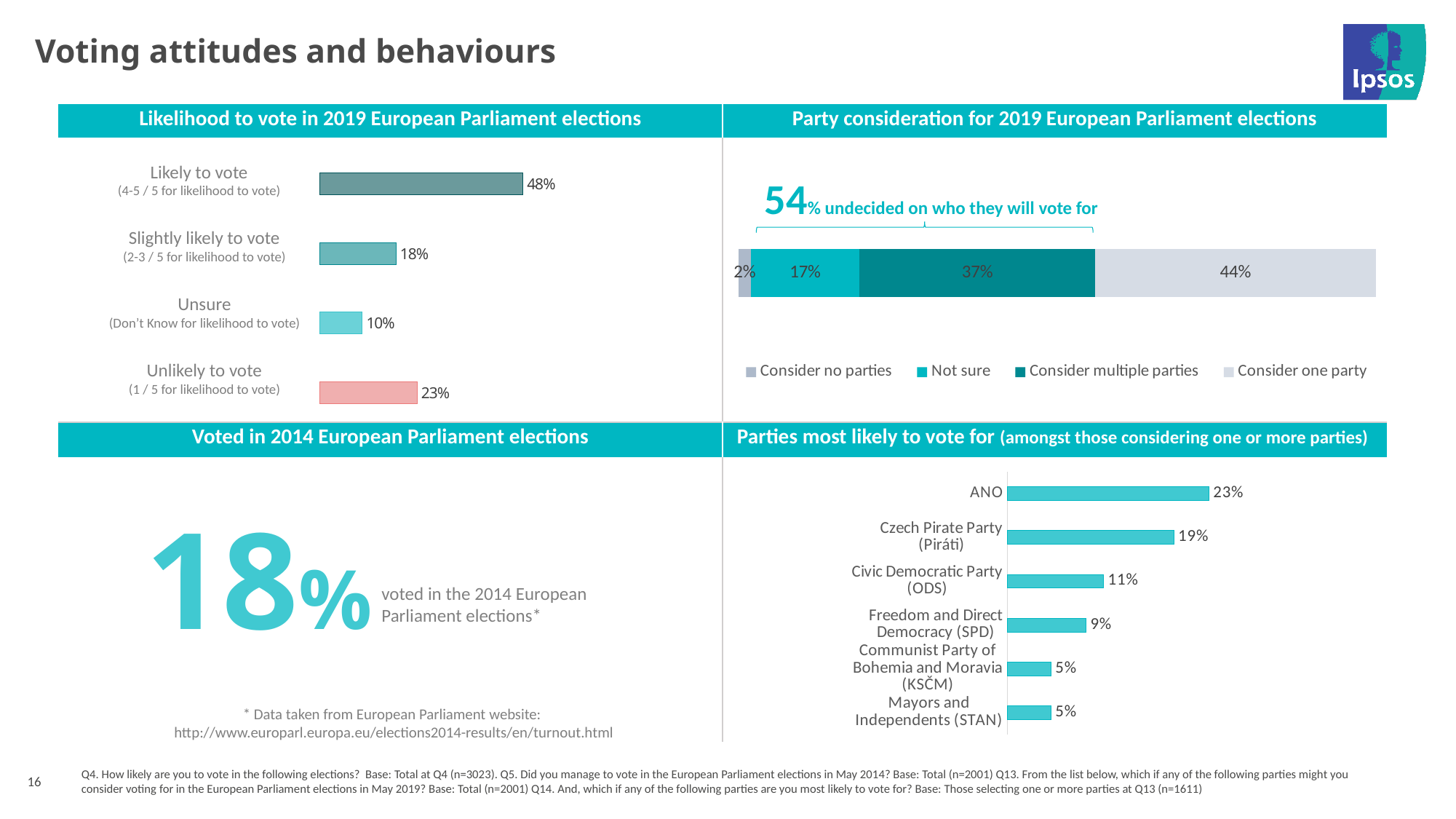
In the 'Likelihood to vote in 2019 European Parliament elections' chart, what percentage are likely to vote? 48% In the 'Party consideration for 2019 European Parliament elections' chart, how many series does the legend list? 4 In the 'Parties most likely to vote for' chart, what is the difference between ANO and Civic Democratic Party (ODS)? 12% In the 'Likelihood to vote in 2019 European Parliament elections' chart, how many categories are shown? 4 In the 'Parties most likely to vote for' chart, what percentage is shown for the Czech Pirate Party (Piráti)? 19% What kind of chart is the 'Parties most likely to vote for' chart? Bar chart In the 'Parties most likely to vote for' chart, which party has the highest value? ANO In the 'Party consideration for 2019 European Parliament elections' chart, which segment is the largest? Consider one party In the 'Likelihood to vote in 2019 European Parliament elections' chart, what is the difference between 'Likely to vote' and 'Unlikely to vote'? 25% In the 'Party consideration for 2019 European Parliament elections' chart, what percentage consider multiple parties? 37% In the 'Party consideration for 2019 European Parliament elections' chart, what is the total of the 'Not sure' and 'Consider multiple parties' segments? 54% In the 'Likelihood to vote in 2019 European Parliament elections' chart, which category has the lowest value? Unsure